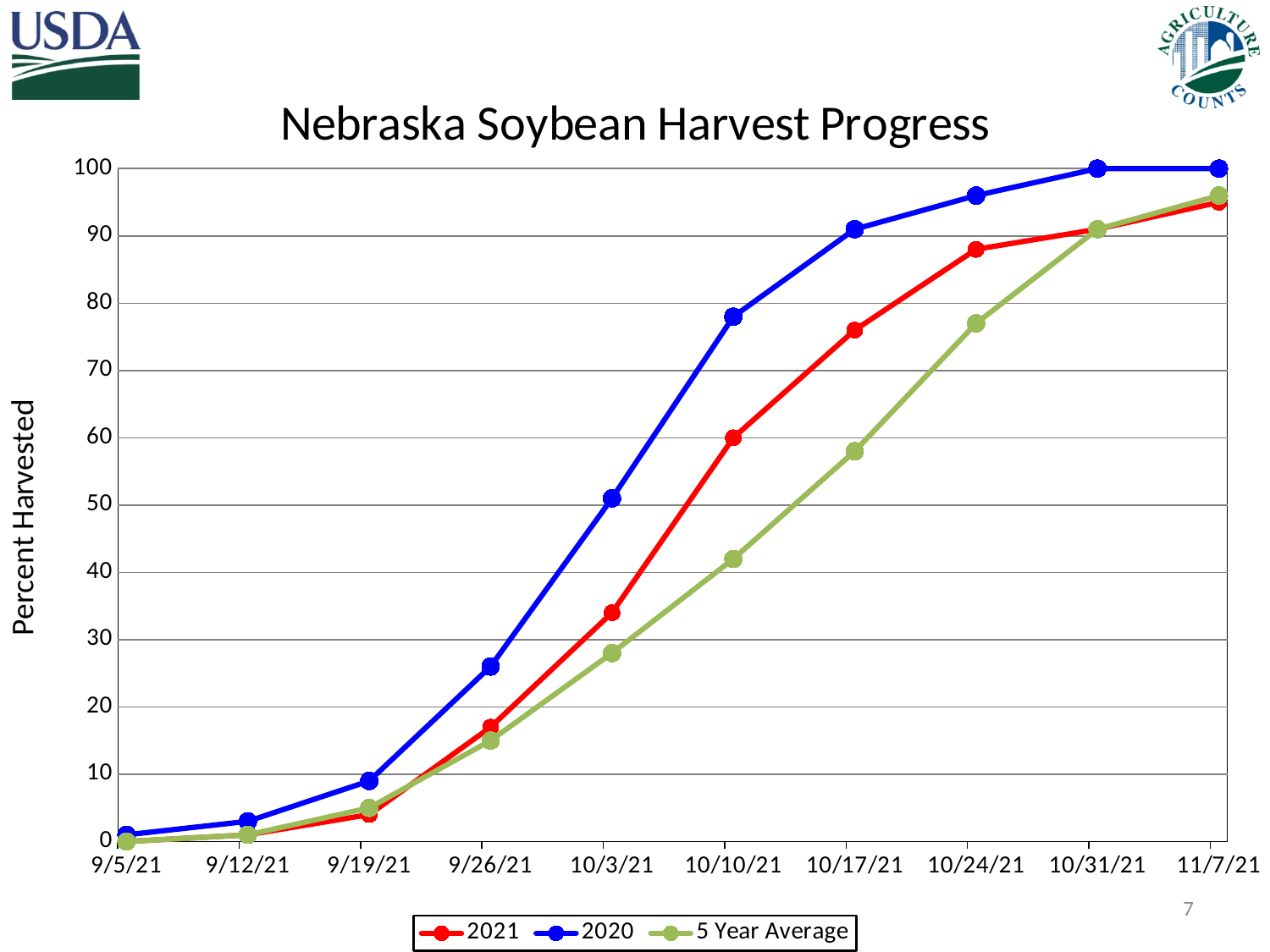
Which series has the highest value on 10/24/21? 2020 What is the label on the y axis? Percent Harvested How many dates are shown along the x axis? 10 What is the value for 2020 on 10/31/21? 100 On 10/3/21, which is larger: the value for 2020 or the value for 2021? 2020 What kind of chart is shown on the slide? line chart Is the value for 2021 on 10/3/21 greater or less than 40? less Is the value for 2020 on 10/10/21 greater or less than 70? greater Is the value for the 5 Year Average on 10/17/21 greater or less than 50? greater What is the value for 2020 on 11/7/21? 100 How many series does the legend list? 3 Do the values for 2021 rise or fall from 9/5/21 to 11/7/21? rise